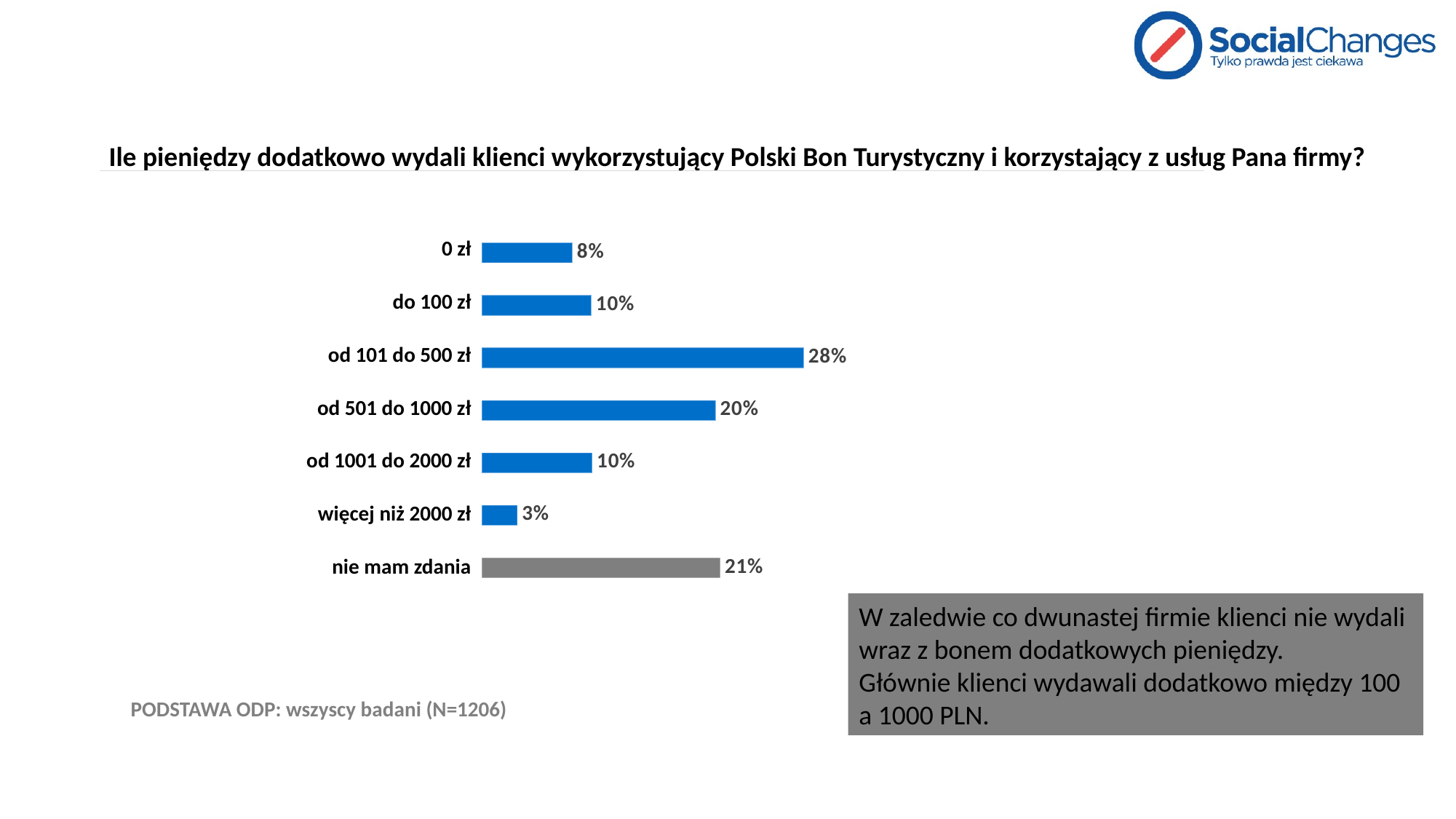
What kind of chart is shown on the slide? bar chart Which category has the lowest value? więcej niż 2000 zł Which category's bar is coloured grey instead of blue? nie mam zdania What is the sample size (N) stated at the bottom of the slide? N=1206 Which category has the highest value? od 101 do 500 zł What is the value for "nie mam zdania"? 21% What percentage is shown for "0 zł"? 8% What is the difference between the values for "od 101 do 500 zł" and "od 501 do 1000 zł"? 8% How many categories are shown in the chart? 7 What is the value for "więcej niż 2000 zł"? 3% Which is larger, the value for "nie mam zdania" or the value for "od 501 do 1000 zł"? nie mam zdania What percentage is shown for "od 101 do 500 zł"? 28%